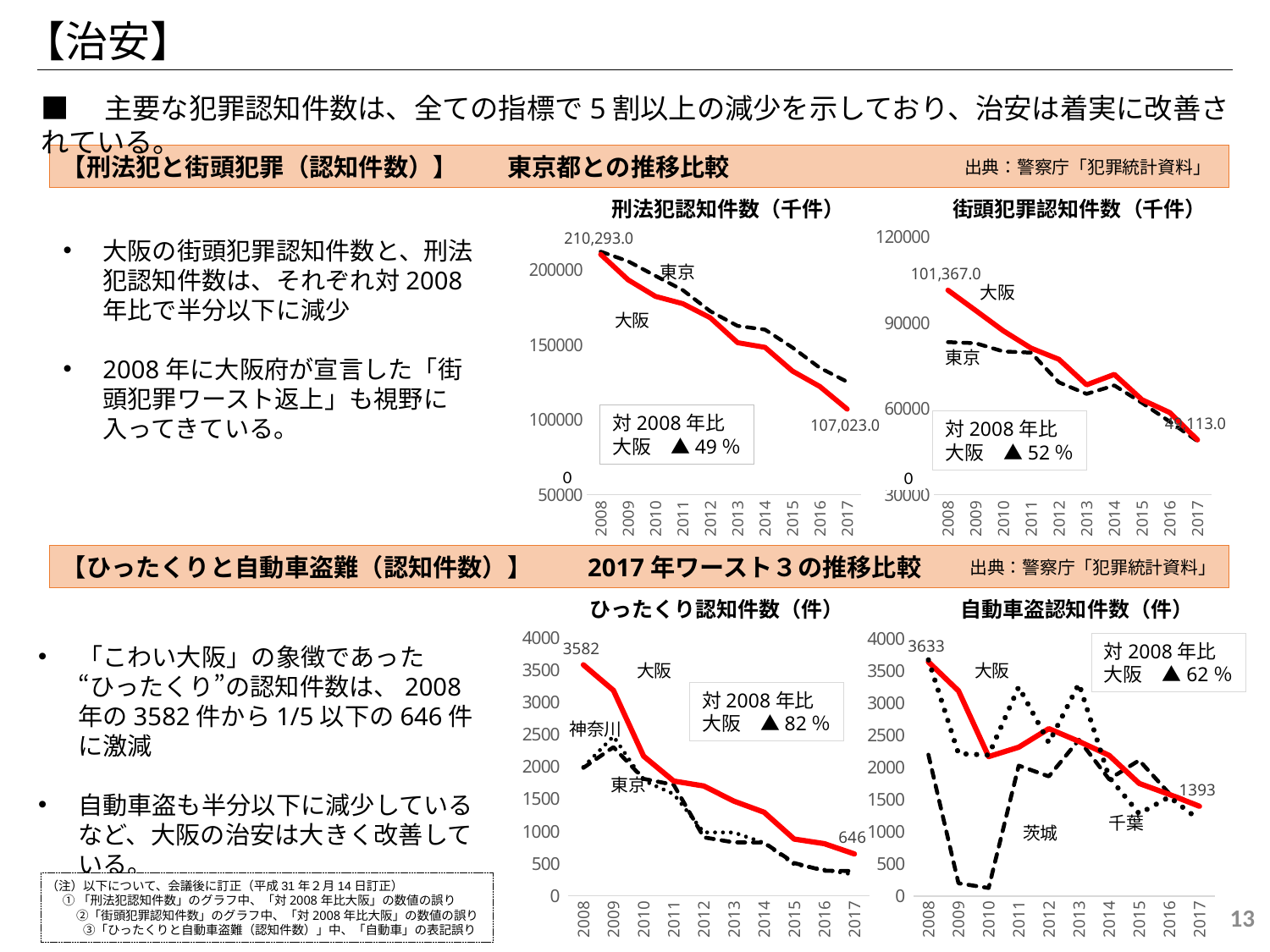
In the 刑法犯認知件数（千件） chart, what is the value for 大阪 in 2008? 210,293.0 In the ひったくり認知件数（件） chart, what is the value for 大阪 in 2017? 646 In the 街頭犯罪認知件数（千件） chart, what is the value for 大阪 in 2008? 101,367.0 In the 自動車盗認知件数（件） chart, what is the difference between the 大阪 values for 2008 and 2017? 2240 In the ひったくり認知件数（件） chart, which is larger in 2008, 大阪 or 東京? 大阪 In the ひったくり認知件数（件） chart, what is the value for 大阪 in 2008? 3582 In the 刑法犯認知件数（千件） chart, what is the value for 大阪 in 2017? 107,023.0 In the 刑法犯認知件数（千件） chart, is the value for 東京 in 2017 greater or less than 150000? less In the ひったくり認知件数（件） chart, what is the difference between the 大阪 values for 2008 and 2017? 2936 In the 刑法犯認知件数（千件） chart, by how much did the 大阪 value fall from 2008 to 2017? 103,270.0 In the 自動車盗認知件数（件） chart, what is the value for 大阪 in 2017? 1393 In the 刑法犯認知件数（千件） chart, how many years are shown on the x axis? 10